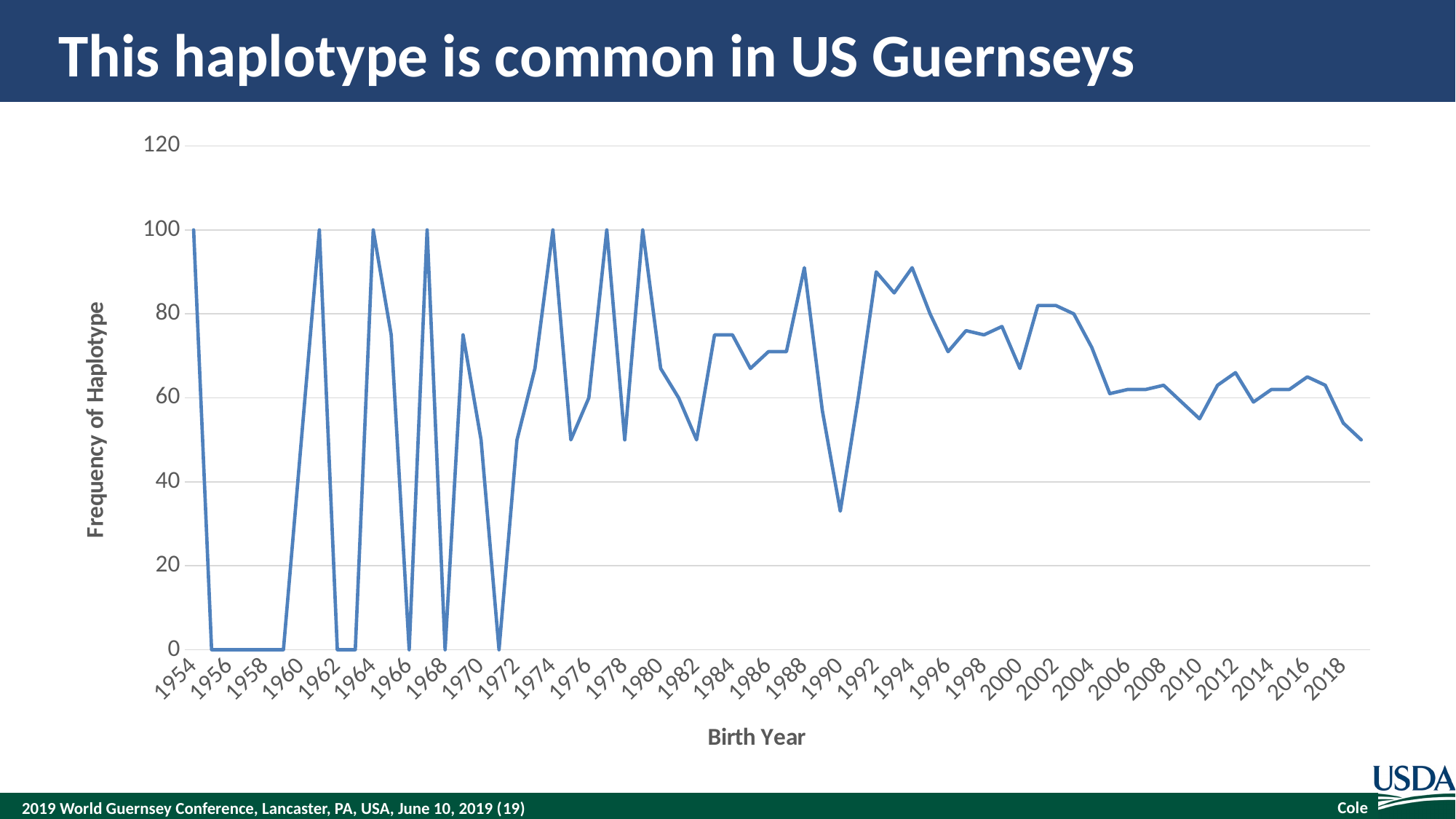
Is the value for birth year 2010 greater or less than 60? less Is the value for birth year 1990 greater or less than 40? less Is the value for birth year 1988 greater or less than 80? greater Which birth year has the higher frequency, 1988 or 1990? 1988 What is the title of the y axis? Frequency of Haplotype What is the frequency of the haplotype for birth year 1968? 0 What kind of chart is shown on the slide? line chart What is the frequency of the haplotype for birth year 1954? 100 What is the frequency of the haplotype for birth year 1956? 0 What is the frequency of the haplotype for birth year 1974? 100 Do the values generally rise or fall from birth year 2004 to 2018? fall